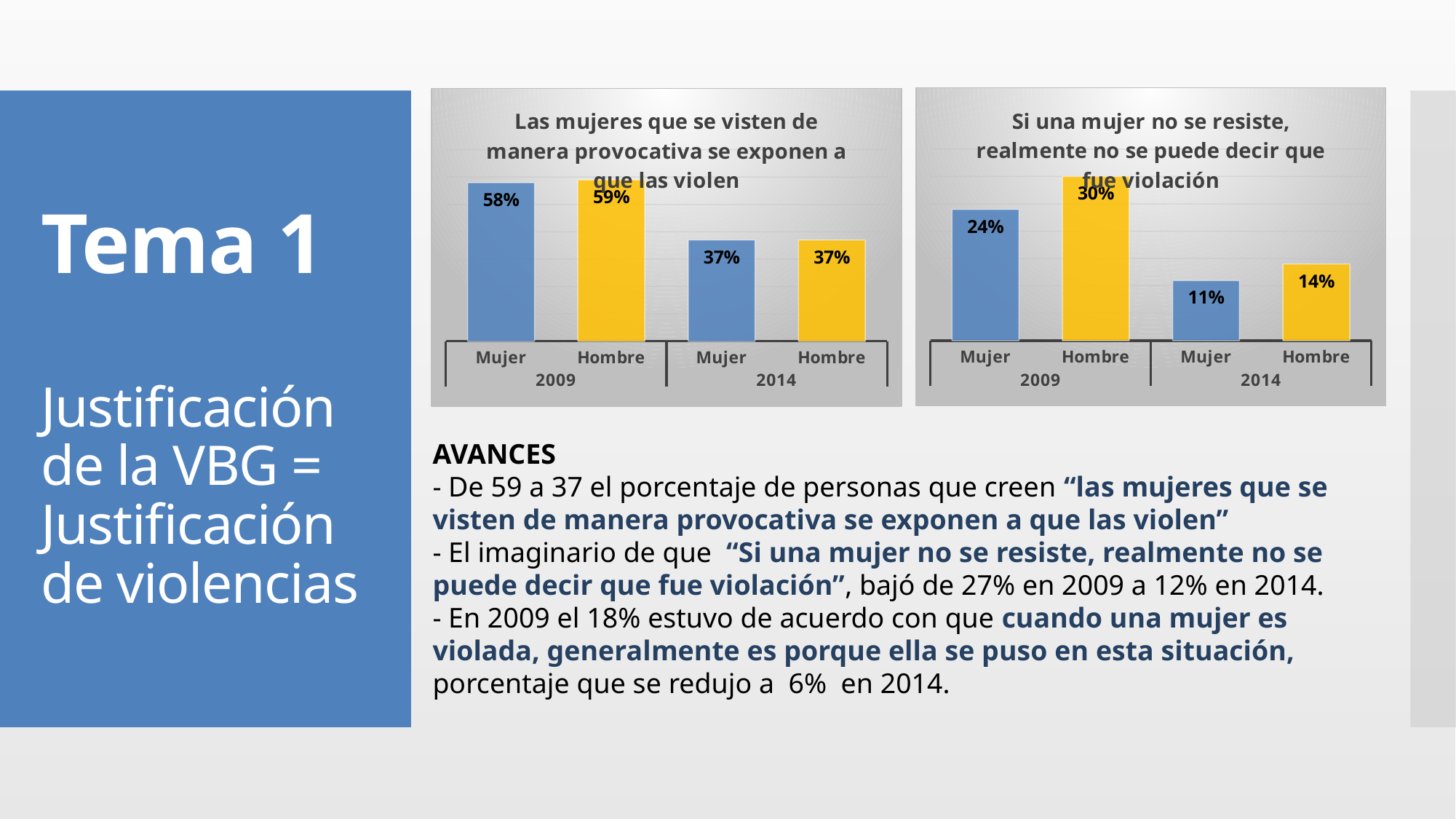
What kind of chart is the right chart ("Si una mujer no se resiste...")? Bar chart In the left chart ("Las mujeres que se visten de manera provocativa..."), what is the difference between the Mujer value in 2009 and the Mujer value in 2014? 21% How many bars are plotted in the left chart ("Las mujeres que se visten de manera provocativa...")? 4 In the right chart ("Si una mujer no se resiste..."), which is larger in 2014: the Mujer value or the Hombre value? Hombre In the right chart ("Si una mujer no se resiste..."), which bar has the lowest value? Mujer 2014 In the left chart ("Las mujeres que se visten de manera provocativa..."), what is the value for Hombre in 2014? 37% In the right chart ("Si una mujer no se resiste..."), which bar has the highest value? Hombre 2009 In the left chart ("Las mujeres que se visten de manera provocativa se exponen a que las violen"), what is the value for Mujer in 2009? 58% In the right chart ("Si una mujer no se resiste, realmente no se puede decir que fue violación"), what is the value for Hombre in 2009? 30% In the right chart ("Si una mujer no se resiste..."), what is the difference between the Hombre value in 2009 and the Hombre value in 2014? 16% In the right chart ("Si una mujer no se resiste..."), what is the value for Mujer in 2014? 11% In the left chart ("Las mujeres que se visten de manera provocativa..."), do the values for Hombre rise or fall from 2009 to 2014? Fall